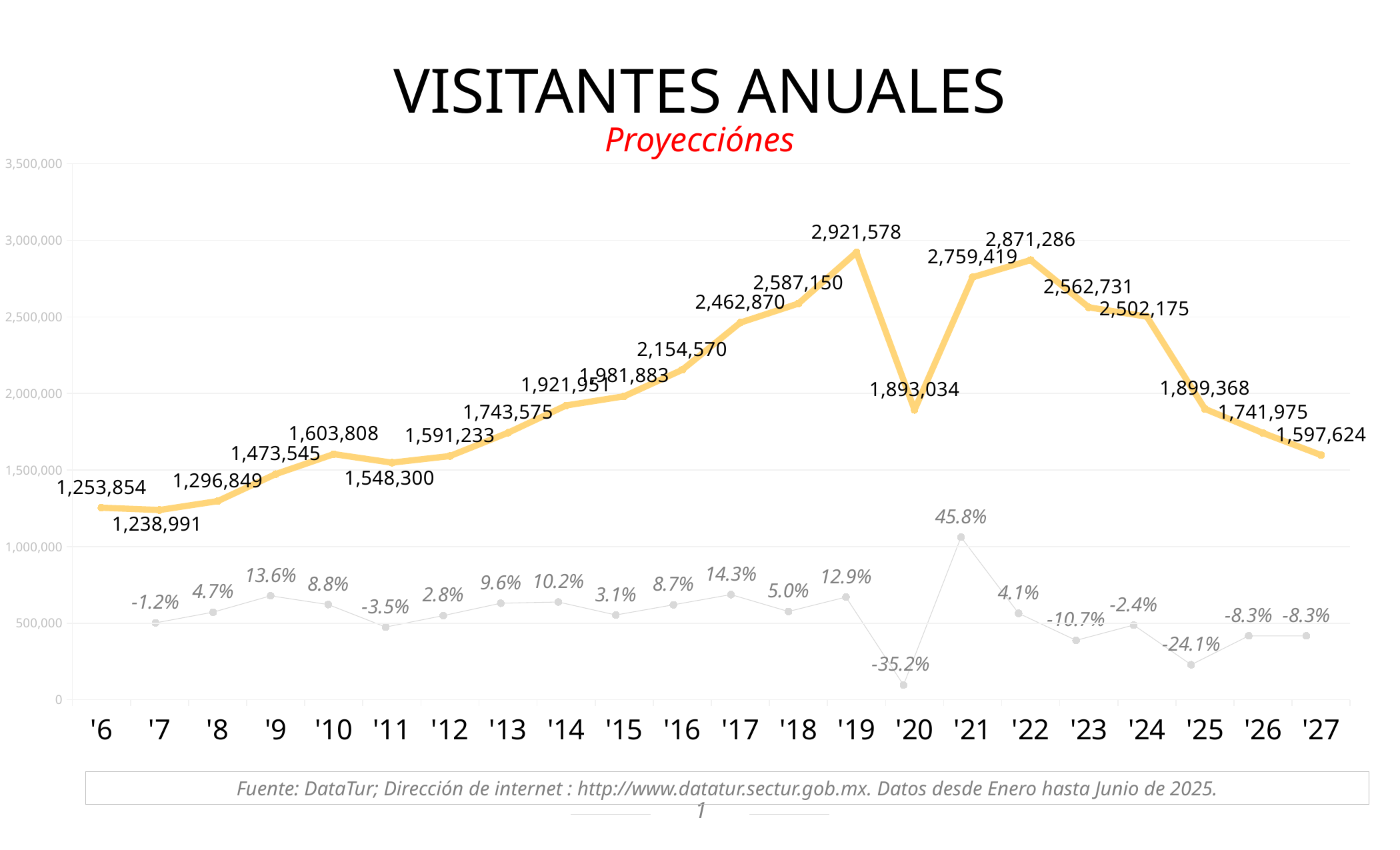
Which year has the highest number of annual visitors? '19 What is the subtitle shown in red under the chart title? Proyecciónes What is the number of annual visitors for '20? 1,893,034 Which year has more annual visitors, '22 or '21? '22 What is the number of annual visitors for '19? 2,921,578 What type of chart is shown on the slide? Line chart Which year has the lowest number of annual visitors? '7 How many years are plotted on the x axis? 22 What is the difference in annual visitors between '19 and '20? 1,028,544 Which year shows the lowest percentage change? '20 What is the projected number of annual visitors for '27? 1,597,624 What percentage change is shown for '21? 45.8%